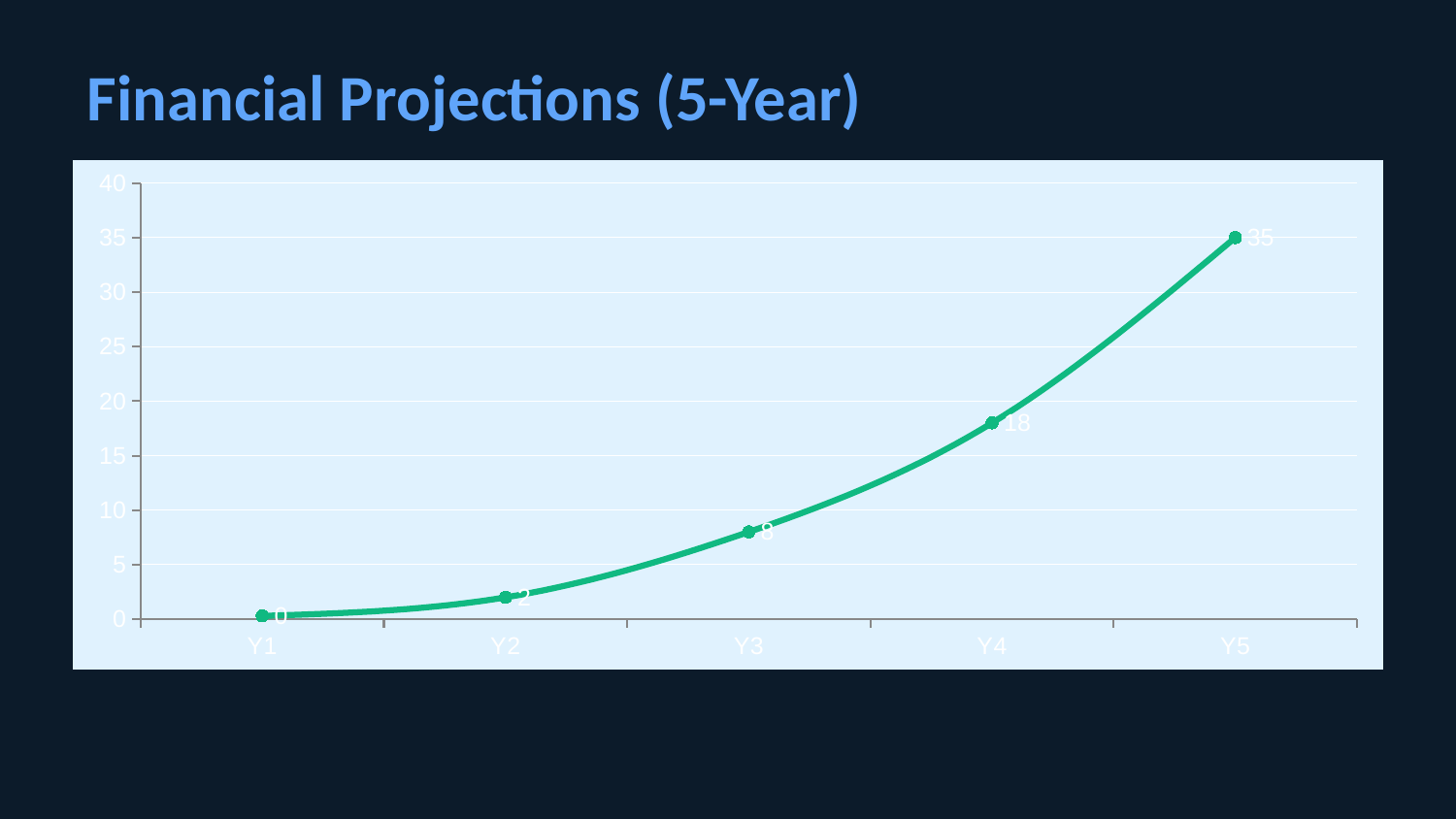
What is the value for Y5? 35 Which is larger, the value for Y3 or the value for Y4? Y4 What is the difference between the values for Y5 and Y4? 17 What is the value for Y2? 2 Do the values rise or fall from Y1 to Y5? rise What is the value for Y3? 8 What is the value for Y4? 18 Which year has the lowest value? Y1 Is the value for Y4 greater or less than 15? greater What kind of chart is shown on the slide? line chart Which year has the highest value? Y5 How many years are plotted on the x axis? 5